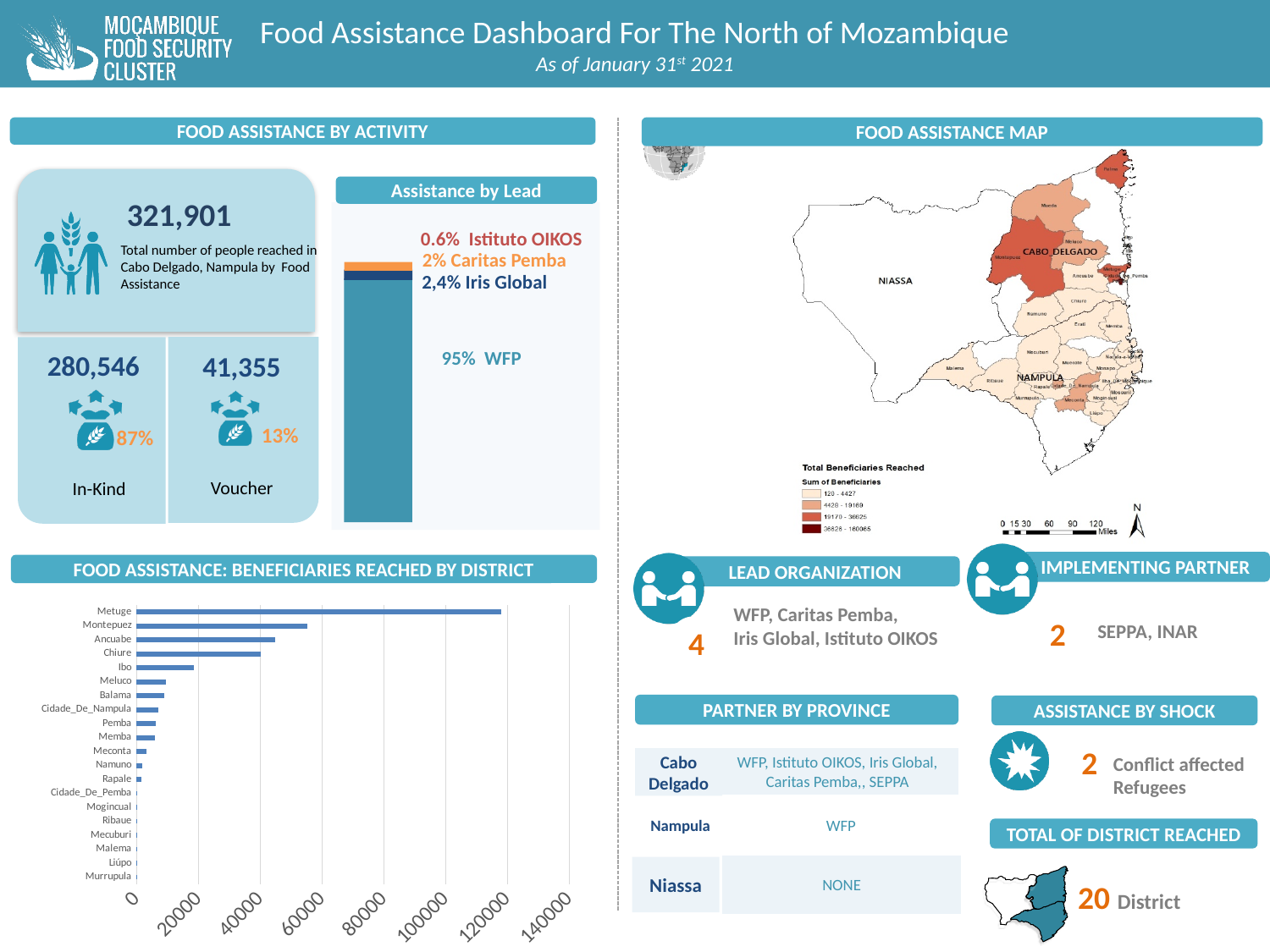
In the 'Food Assistance: Beneficiaries Reached by District' chart, is the value for Montepuez greater or less than 60000? less In the 'Assistance by Lead' chart, which organization has the smallest share? Istituto OIKOS In the 'Food Assistance: Beneficiaries Reached by District' chart, which district has more beneficiaries reached, Metuge or Chiure? Metuge In the 'Assistance by Lead' chart, what share of assistance is led by WFP? 95% How many districts are listed in the 'Food Assistance: Beneficiaries Reached by District' chart? 20 In the 'Assistance by Lead' chart, what share of assistance is led by Caritas Pemba? 2% In the 'Food Assistance: Beneficiaries Reached by District' chart, is the value for Metuge greater or less than 100000? greater In the 'Food Assistance: Beneficiaries Reached by District' chart, which district has the highest number of beneficiaries reached? Metuge In the 'Food Assistance: Beneficiaries Reached by District' chart, which district has more beneficiaries reached, Montepuez or Ancuabe? Montepuez In the 'Food Assistance: Beneficiaries Reached by District' chart, what kind of chart is used? bar chart In the 'Assistance by Lead' chart, what share of assistance is led by Iris Global? 2,4%